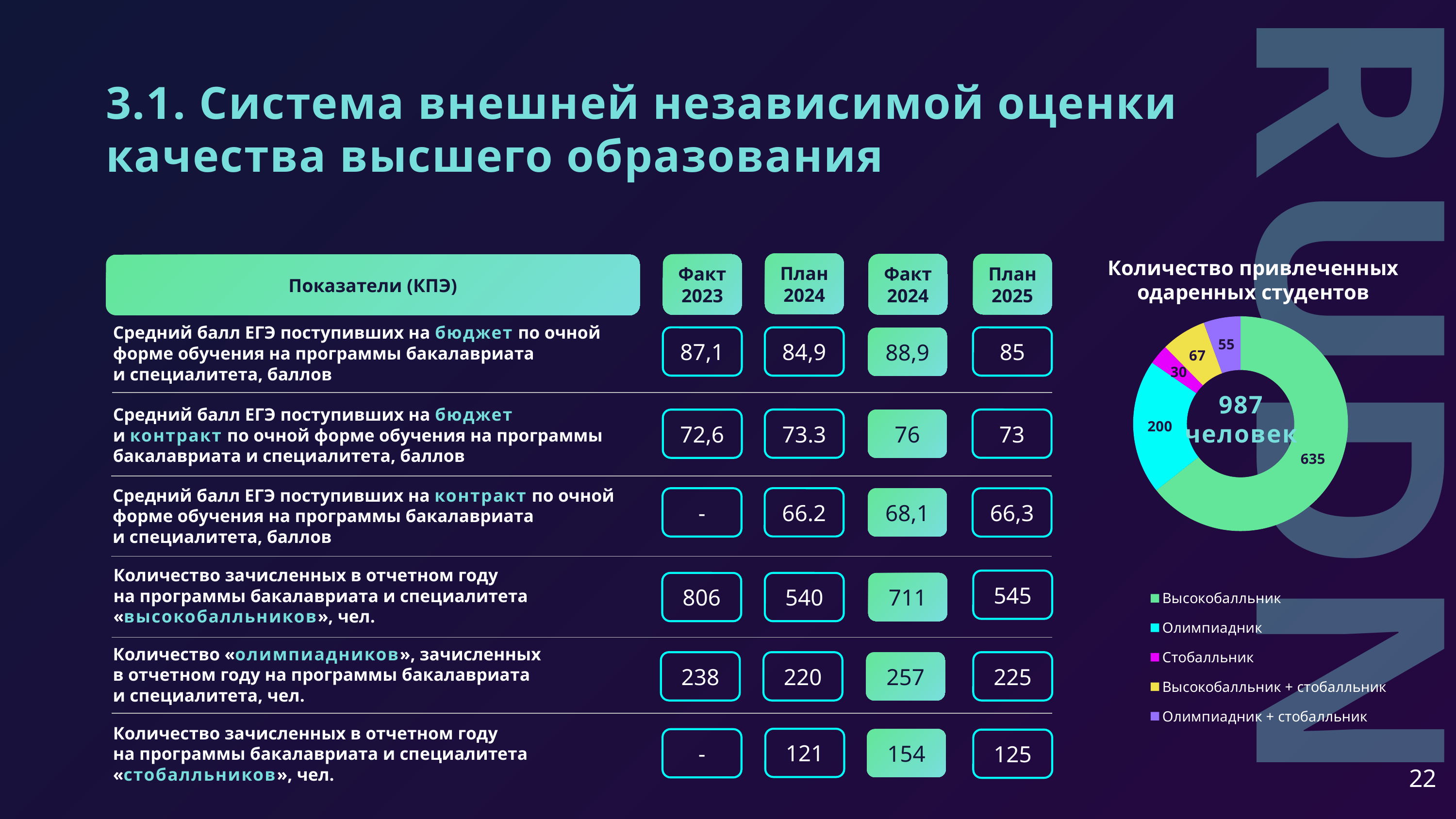
What type of chart is shown under the title "Количество привлеченных одаренных студентов"? Pie chart (donut) Which category has the smallest slice in the donut chart? Стобалльник In the donut chart, what is the value for "Высокобалльник"? 635 What total number of people is shown in the centre of the donut chart? 987 человек In the donut chart, what is the value for "Высокобалльник + стобалльник"? 67 In the donut chart, what is the difference between the values for "Высокобалльник" and "Олимпиадник"? 435 In the donut chart, what is the value for "Олимпиадник"? 200 In the donut chart, what is the value for "Стобалльник"? 30 In the donut chart, what is the value for "Олимпиадник + стобалльник"? 55 In the donut chart, which is larger: "Высокобалльник + стобалльник" or "Олимпиадник + стобалльник"? Высокобалльник + стобалльник Which category has the largest slice in the donut chart? Высокобалльник How many categories does the legend of the donut chart list? 5